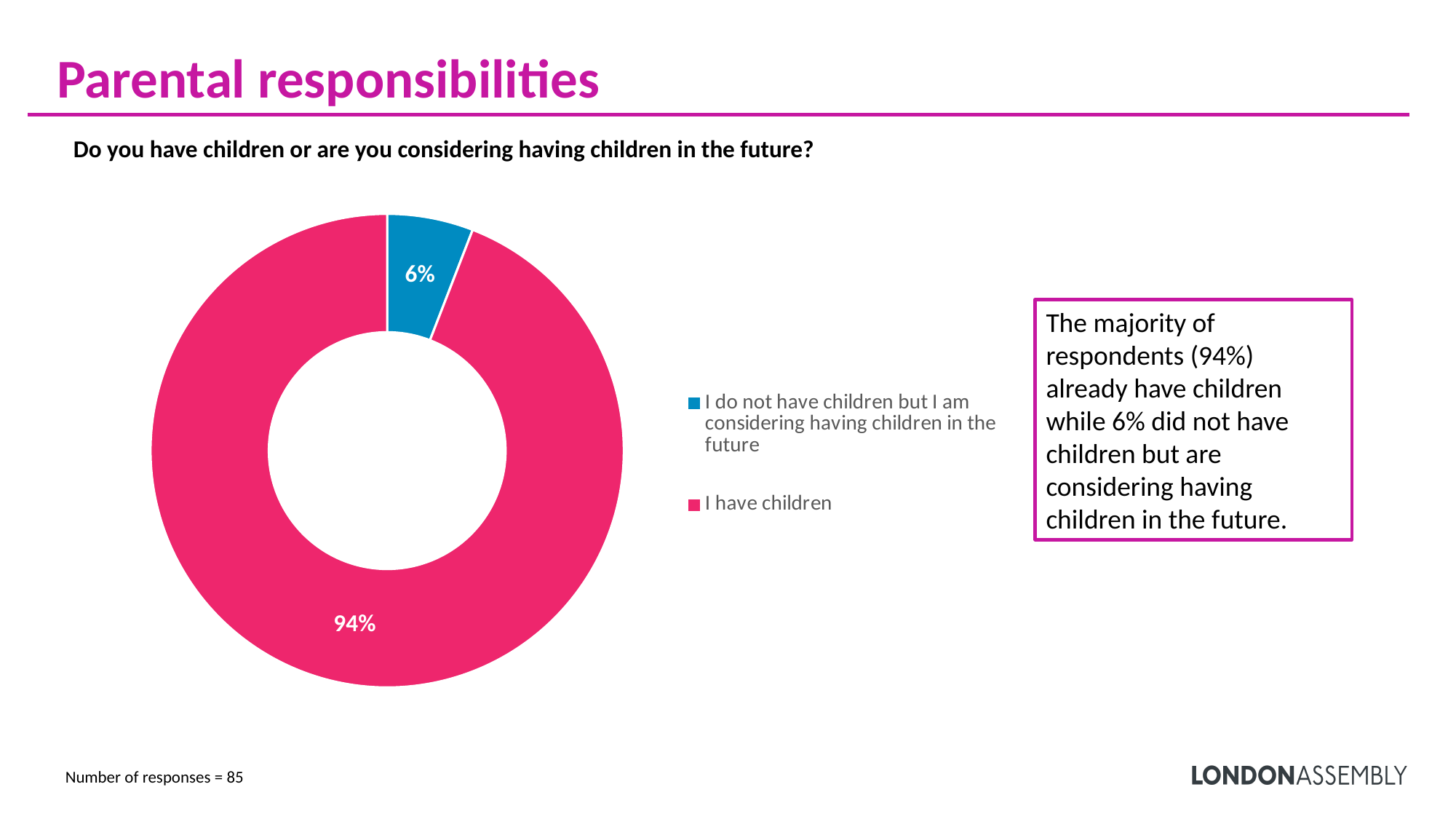
How many responses does the slide say the chart is based on? 85 Which category has the smallest share of the chart? I do not have children but I am considering having children in the future Which is larger: the share for "I have children" or the share for those considering having children in the future? I have children What is the difference in percentage points between "I have children" and "I do not have children but I am considering having children in the future"? 88 What colour is the "I have children" segment? Pink Which category has the largest share of the chart? I have children What percentage of respondents said they do not have children but are considering having children in the future? 6% What is the total of the two percentages shown on the chart? 100% What kind of chart is shown on the slide? Doughnut (pie) chart How many categories does the chart show? 2 What percentage of respondents said "I have children"? 94% What survey question does the chart represent? Do you have children or are you considering having children in the future?